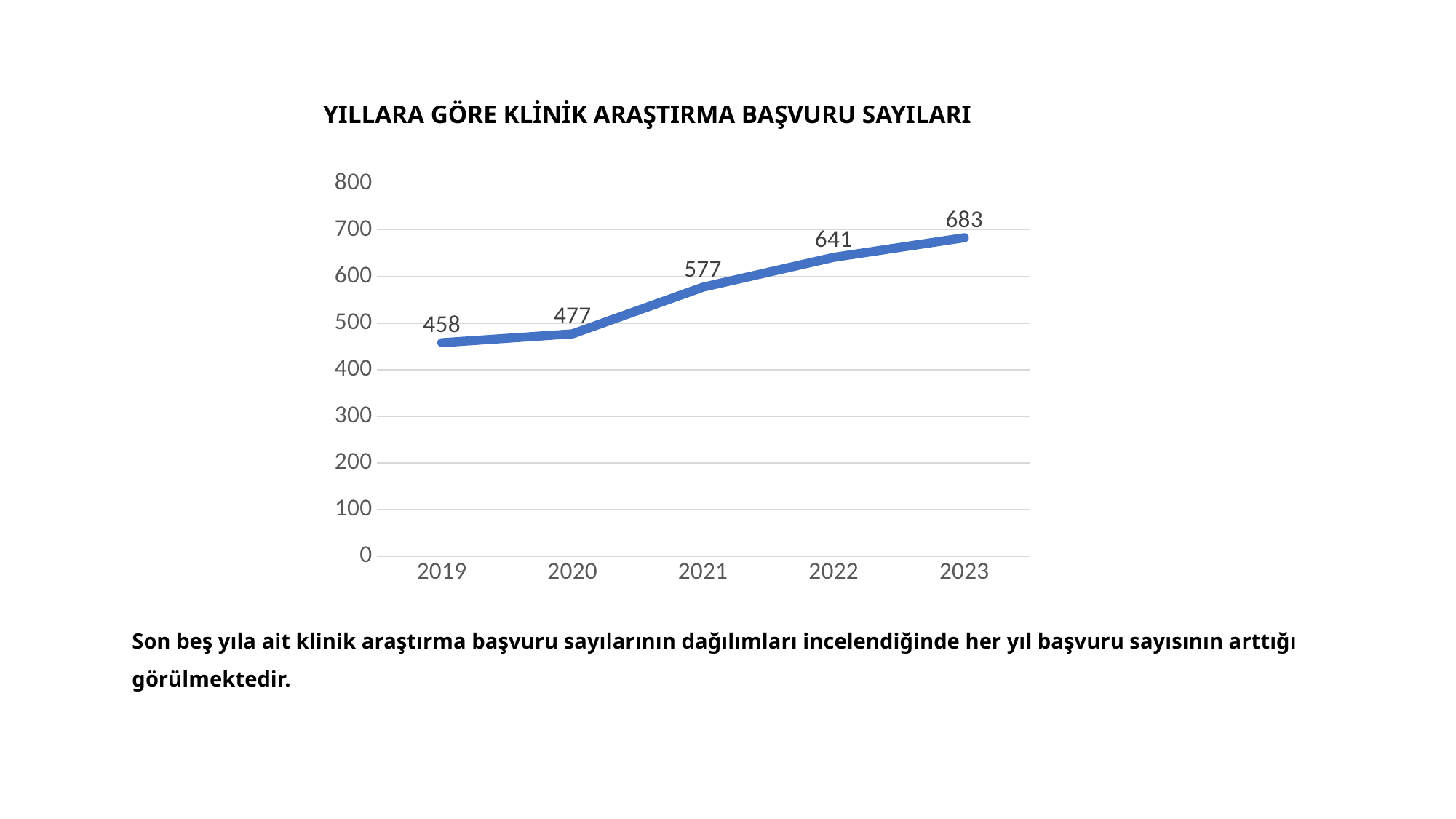
What kind of chart is this? line chart Do the values rise or fall from 2019 to 2023? rise Which year has the lowest value? 2019 What is the value for 2023? 683 How many years are shown on the x axis? 5 What is the value for 2021? 577 What is the value for 2019? 458 What is the difference between the values for 2022 and 2021? 64 What is the difference between the values for 2023 and 2019? 225 Is the value for 2022 greater or less than 600? greater Which year has the highest value? 2023 Which is larger, the value for 2020 or the value for 2022? 2022